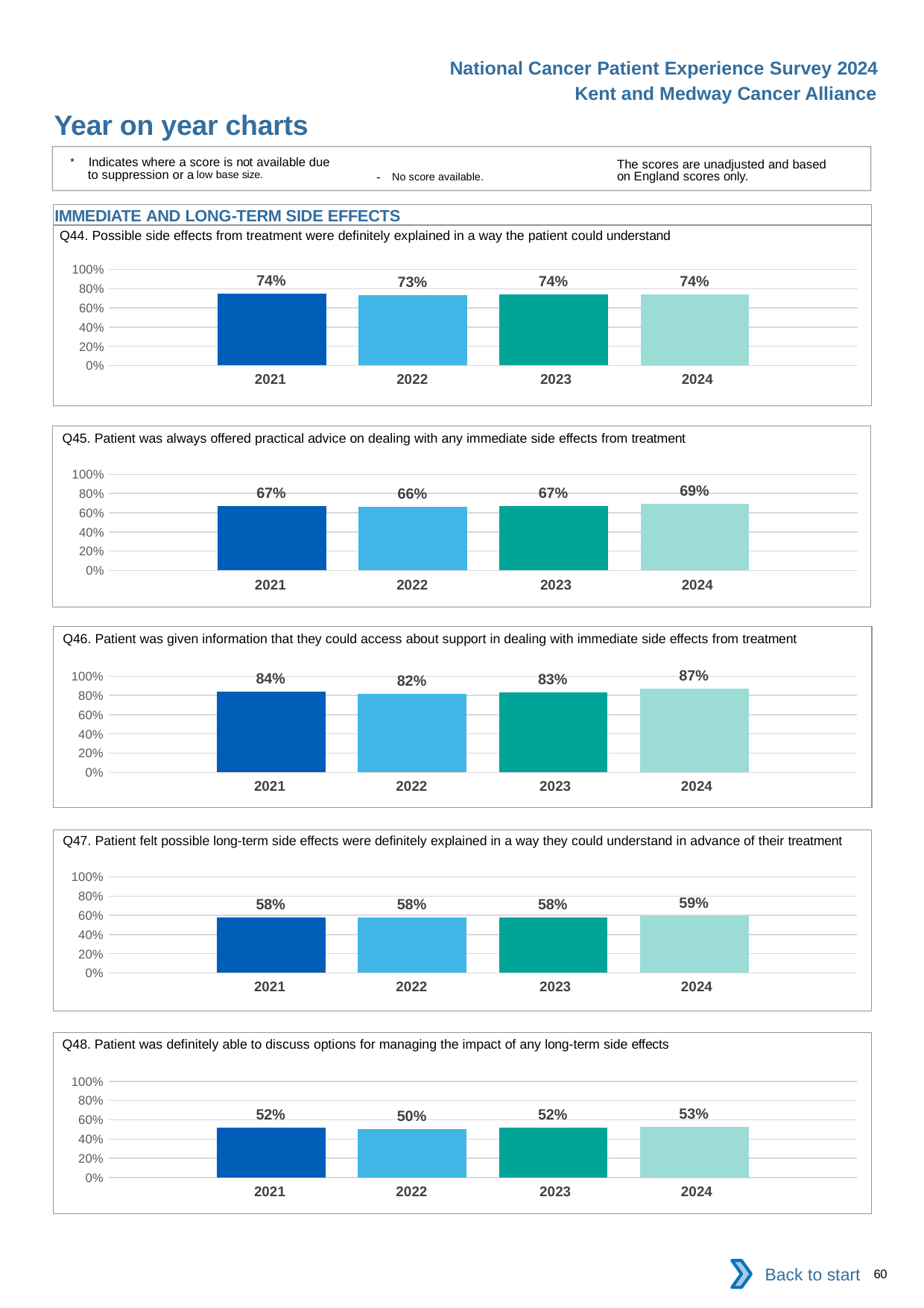
In the Q44 chart, what is the value for 2022? 73% In the Q46 chart, what is the value for 2023? 83% In the Q45 chart, which year has the highest value? 2024 In the Q48 chart, what is the difference between the 2021 value and the 2022 value? 2% In the Q48 chart, which is larger, the value for 2022 or the value for 2024? 2024 What kind of chart is the Q47 chart? bar chart In the Q48 chart, what is the value for 2021? 52% In the Q45 chart, which year has the lowest value? 2022 In the Q46 chart, which year has the highest value? 2024 How many years are shown in the Q44 chart? 4 In the Q47 chart, what is the value for 2024? 59% In the Q46 chart, what is the difference between the 2024 value and the 2022 value? 5%